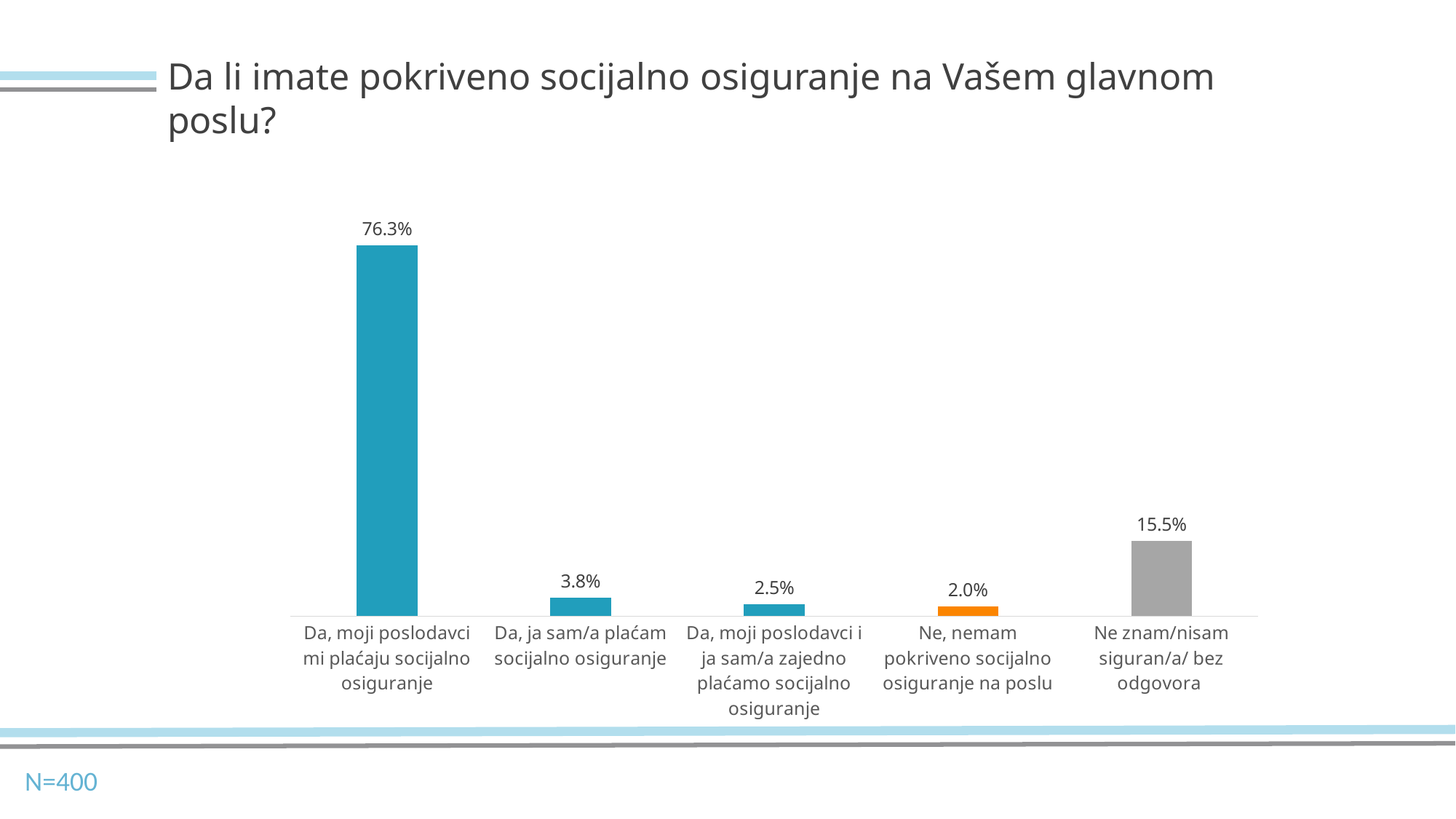
What is the value for 'Da, ja sam/a plaćam socijalno osiguranje'? 3.8% What percentage of respondents said 'Ne, nemam pokriveno socijalno osiguranje na poslu'? 2.0% What percentage of respondents answered 'Da, moji poslodavci mi plaćaju socijalno osiguranje'? 76.3% Which category has the lowest value? Ne, nemam pokriveno socijalno osiguranje na poslu What is the sample size (N) shown on the slide? N=400 What is the difference between 'Da, moji poslodavci mi plaćaju socijalno osiguranje' and 'Ne znam/nisam siguran/a/ bez odgovora'? 60.8% What is the difference between 'Da, ja sam/a plaćam socijalno osiguranje' and 'Da, moji poslodavci i ja sam/a zajedno plaćamo socijalno osiguranje'? 1.3% What type of chart is shown on the slide? Bar chart What is the value for 'Ne znam/nisam siguran/a/ bez odgovora'? 15.5% Which is larger: 'Ne znam/nisam siguran/a/ bez odgovora' or 'Da, ja sam/a plaćam socijalno osiguranje'? Ne znam/nisam siguran/a/ bez odgovora Which category has the highest value? Da, moji poslodavci mi plaćaju socijalno osiguranje How many categories are shown in the chart? 5